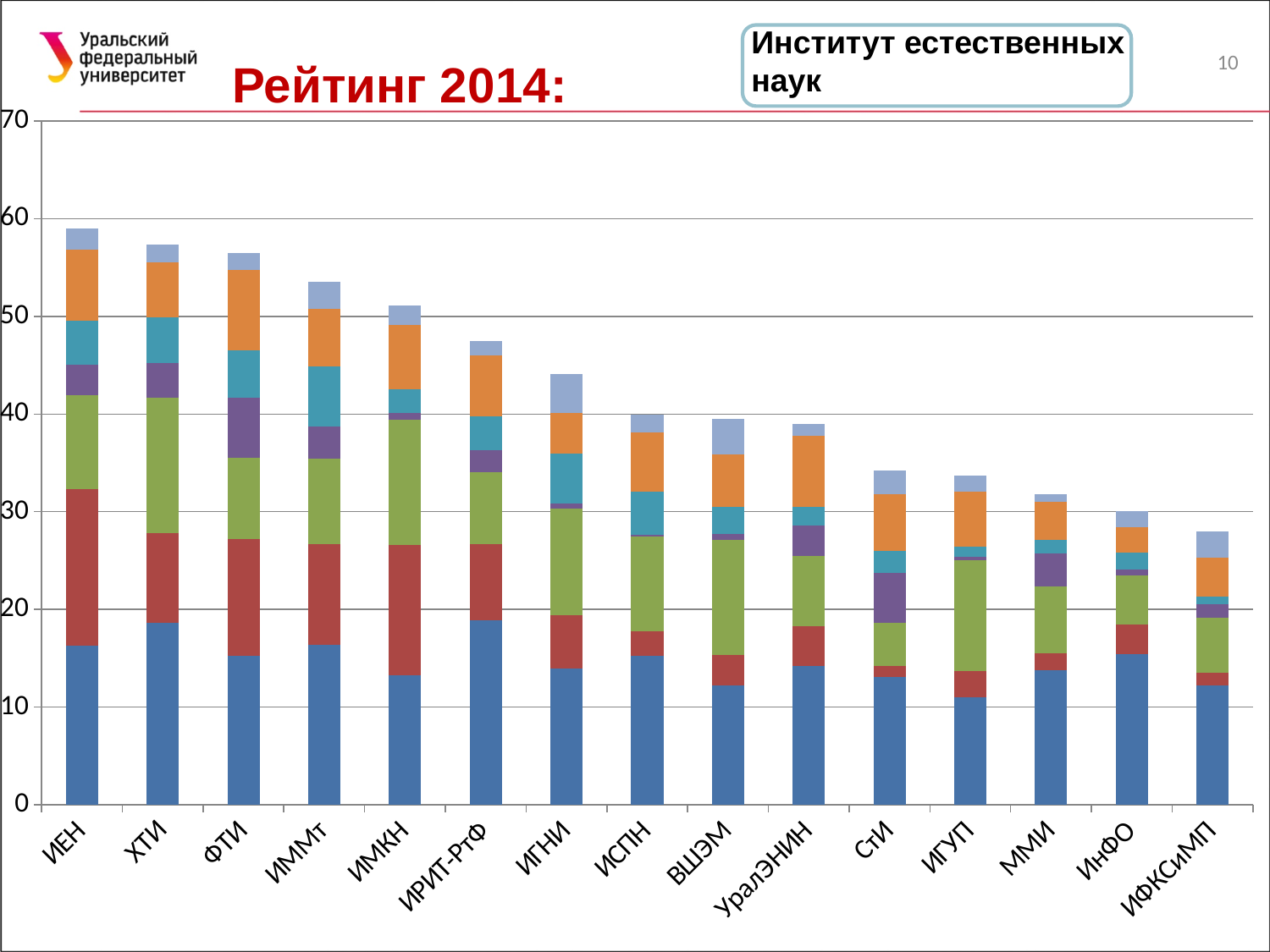
What is the title shown in red above the chart? Рейтинг 2014: What kind of chart is shown on the slide? stacked bar chart Is the total for ИРИТ-РтФ greater or less than 50? less Is the total for ИФКСиМП greater or less than 30? less Is the total for ИГНИ greater or less than 40? greater Which category has the shortest stacked bar? ИФКСиМП Do the bar totals generally rise or fall from left to right along the x axis? fall Which category has the tallest stacked bar? ИЕН How many categories (institutes) are shown along the x axis? 15 Which has the taller stacked bar, ИММт or ИГНИ? ИММт